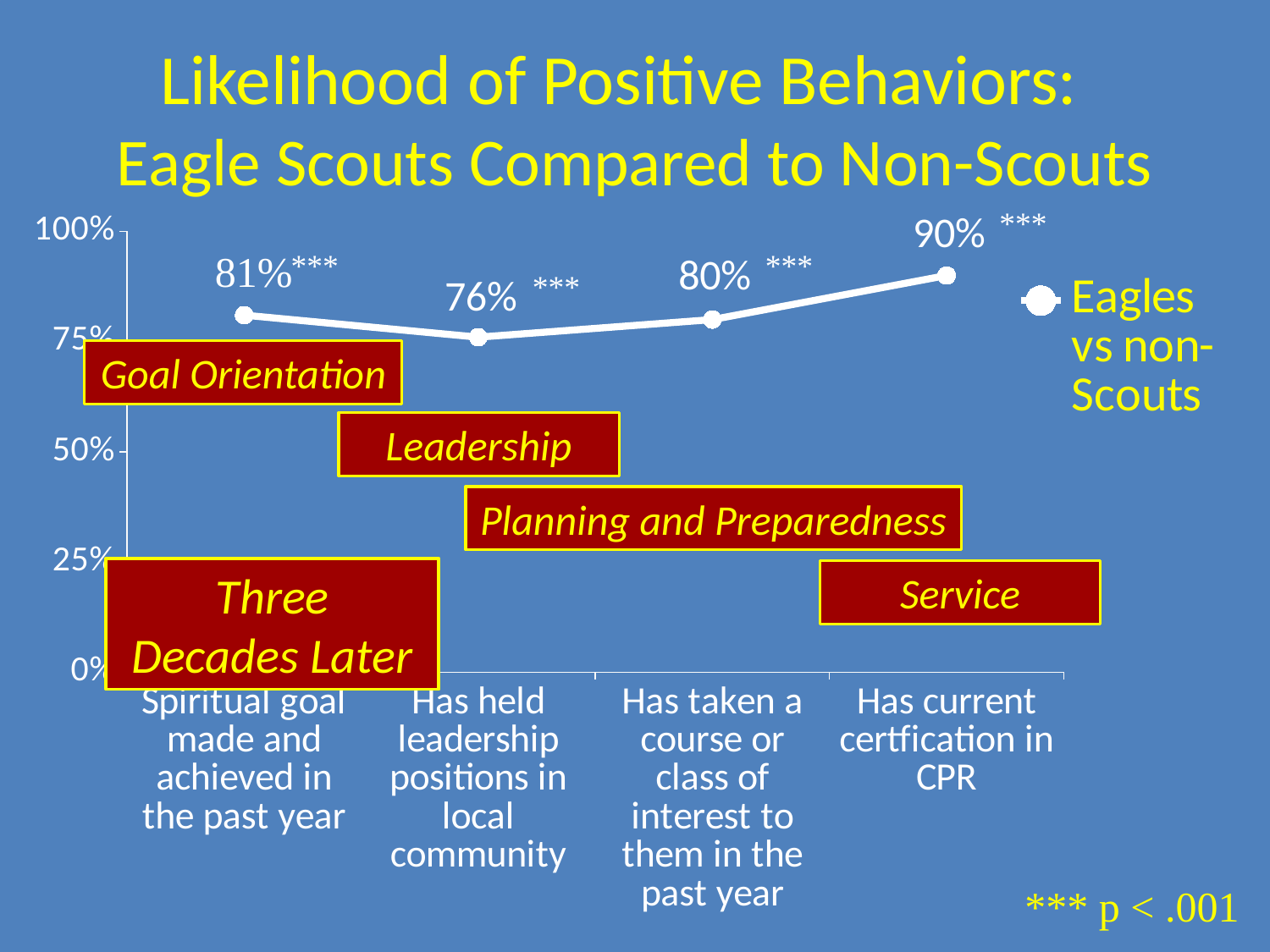
What is the value for 'Spiritual goal made and achieved in the past year'? 81% What kind of chart is shown? line chart Which category has the highest value? Has current certfication in CPR What is the value for 'Has held leadership positions in local community'? 76% What is the name of the series shown in the legend? Eagles vs non-Scouts What is the difference between the values for 'Has current certfication in CPR' and 'Has held leadership positions in local community'? 14% Which category has the lowest value? Has held leadership positions in local community What is the value for 'Has current certfication in CPR'? 90% How many series does the legend list? 1 Which is larger, the value for 'Spiritual goal made and achieved in the past year' or the value for 'Has taken a course or class of interest to them in the past year'? Spiritual goal made and achieved in the past year How many categories are plotted on the x axis? 4 What is the value for 'Has taken a course or class of interest to them in the past year'? 80%